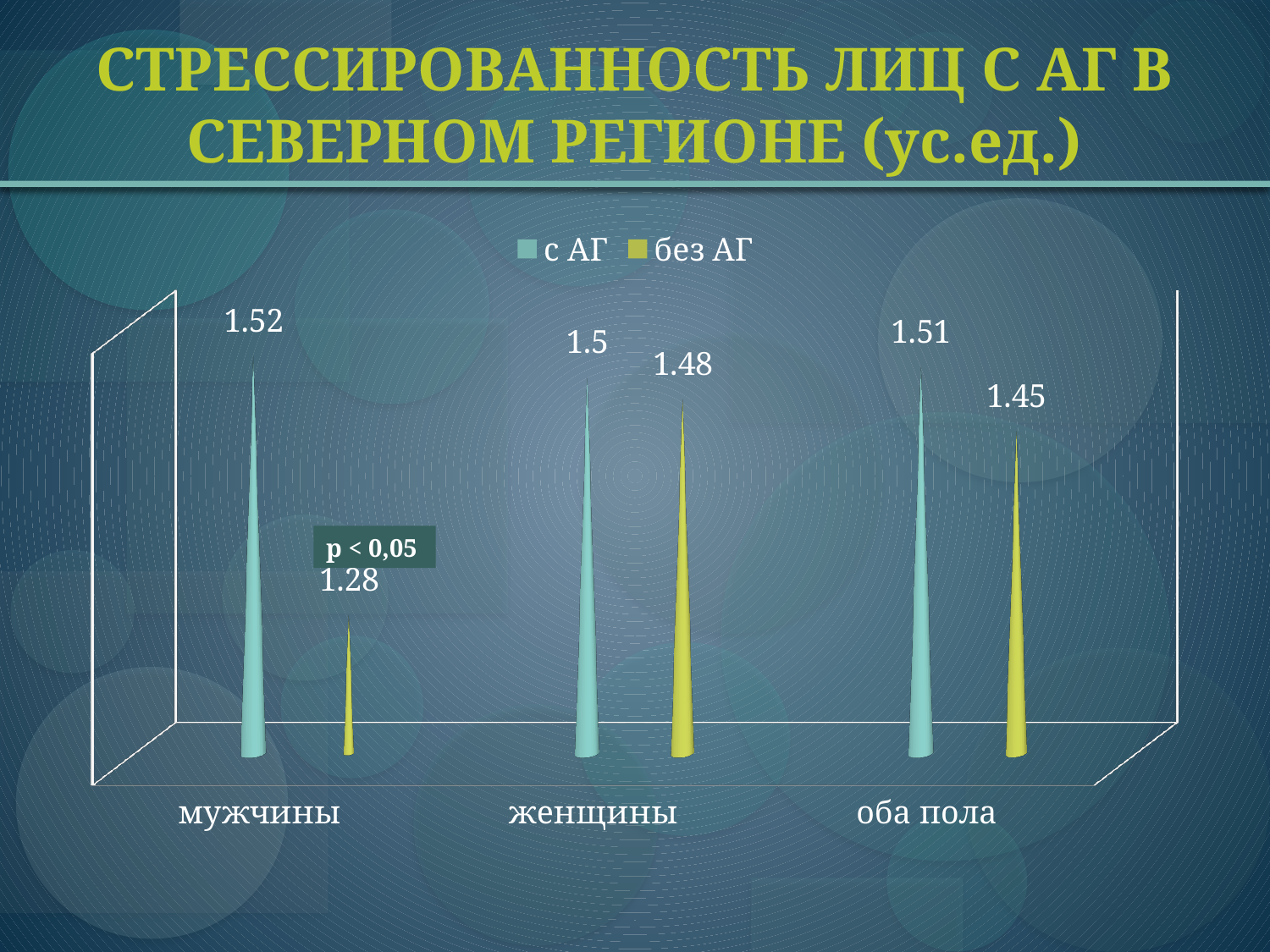
What is the value for мужчины in the с АГ series? 1.52 How many series does the legend list? 2 Which category has the lowest value in the без АГ series? мужчины What is the value for мужчины in the без АГ series? 1.28 Which category has the highest value in the с АГ series? мужчины What is the value for женщины in the с АГ series? 1.5 Which is larger for оба пола: the с АГ value or the без АГ value? с АГ What is the value for женщины in the без АГ series? 1.48 What kind of chart is shown on the slide? bar chart How many categories are shown on the x axis? 3 What is the value for оба пола in the без АГ series? 1.45 What is the difference between the с АГ and без АГ values for мужчины? 0.24